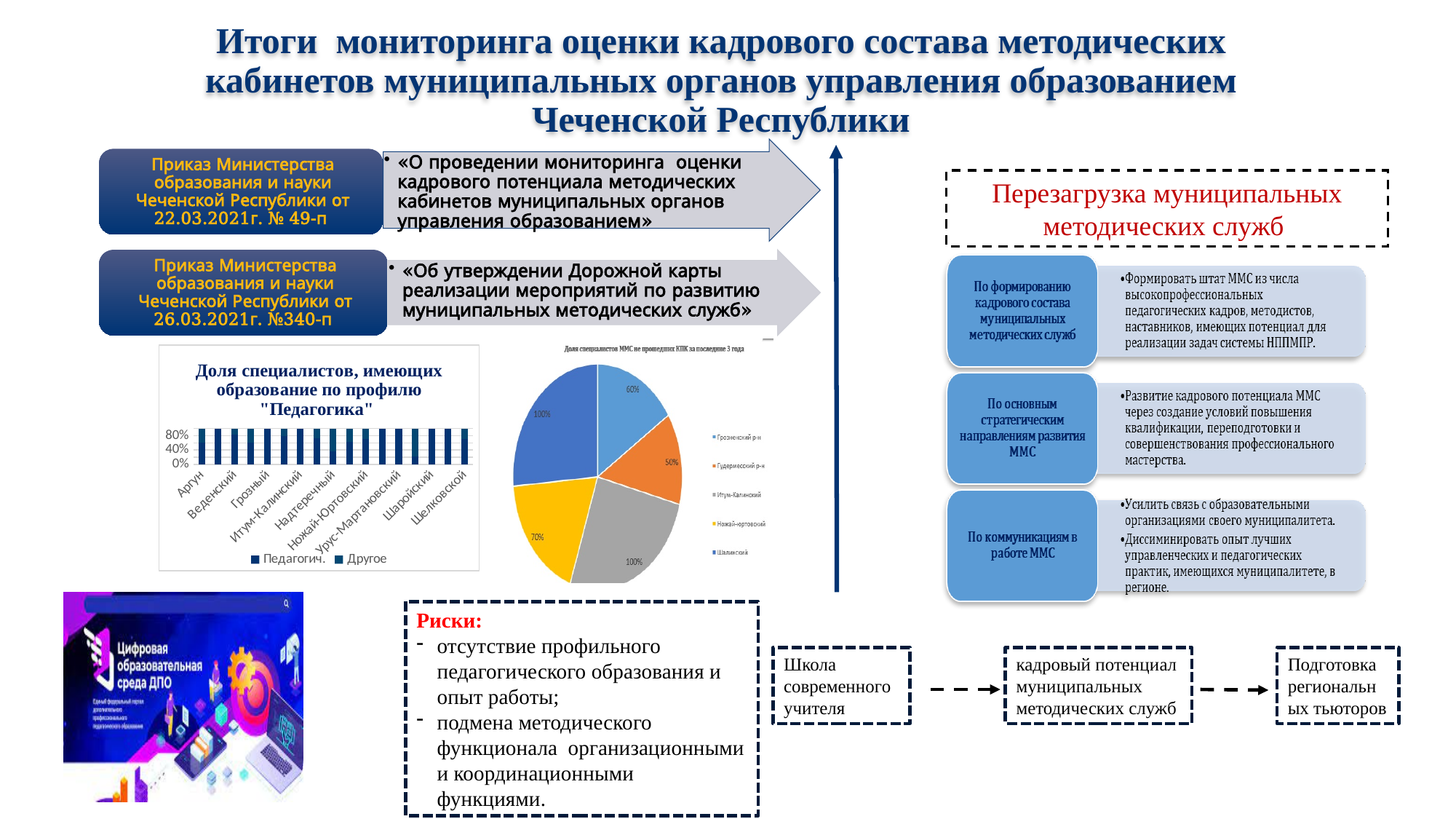
What kind of chart is the chart titled "Доля специалистов, имеющих образование по профилю "Педагогика""? bar chart How many series does the legend of the bar chart "Доля специалистов, имеющих образование по профилю "Педагогика"" list? 2 In the pie chart "Доля специалистов ММС не прошедших КПК за последние 3 года", which has the larger labelled value, Грозненский р-н or Гудермесский р-н? Грозненский р-н What are the two legend entries of the bar chart "Доля специалистов, имеющих образование по профилю "Педагогика""? Педагогич. and Другое How many slices does the pie chart "Доля специалистов ММС не прошедших КПК за последние 3 года" have? 5 What kind of chart is the chart titled "Доля специалистов ММС не прошедших КПК за последние 3 года"? pie chart In the pie chart "Доля специалистов ММС не прошедших КПК за последние 3 года", what value is labelled for Шалинский? 100% In the pie chart "Доля специалистов ММС не прошедших КПК за последние 3 года", what value is labelled for Гудермесский р-н? 50% In the pie chart "Доля специалистов ММС не прошедших КПК за последние 3 года", what value is labelled for Грозненский р-н? 60% How many categories are shown on the x axis of the bar chart "Доля специалистов, имеющих образование по профилю "Педагогика""? 17 In the pie chart "Доля специалистов ММС не прошедших КПК за последние 3 года", what value is labelled for Ножай-юртовский? 70% In the pie chart "Доля специалистов ММС не прошедших КПК за последние 3 года", which district has the lowest labelled value? Гудермесский р-н